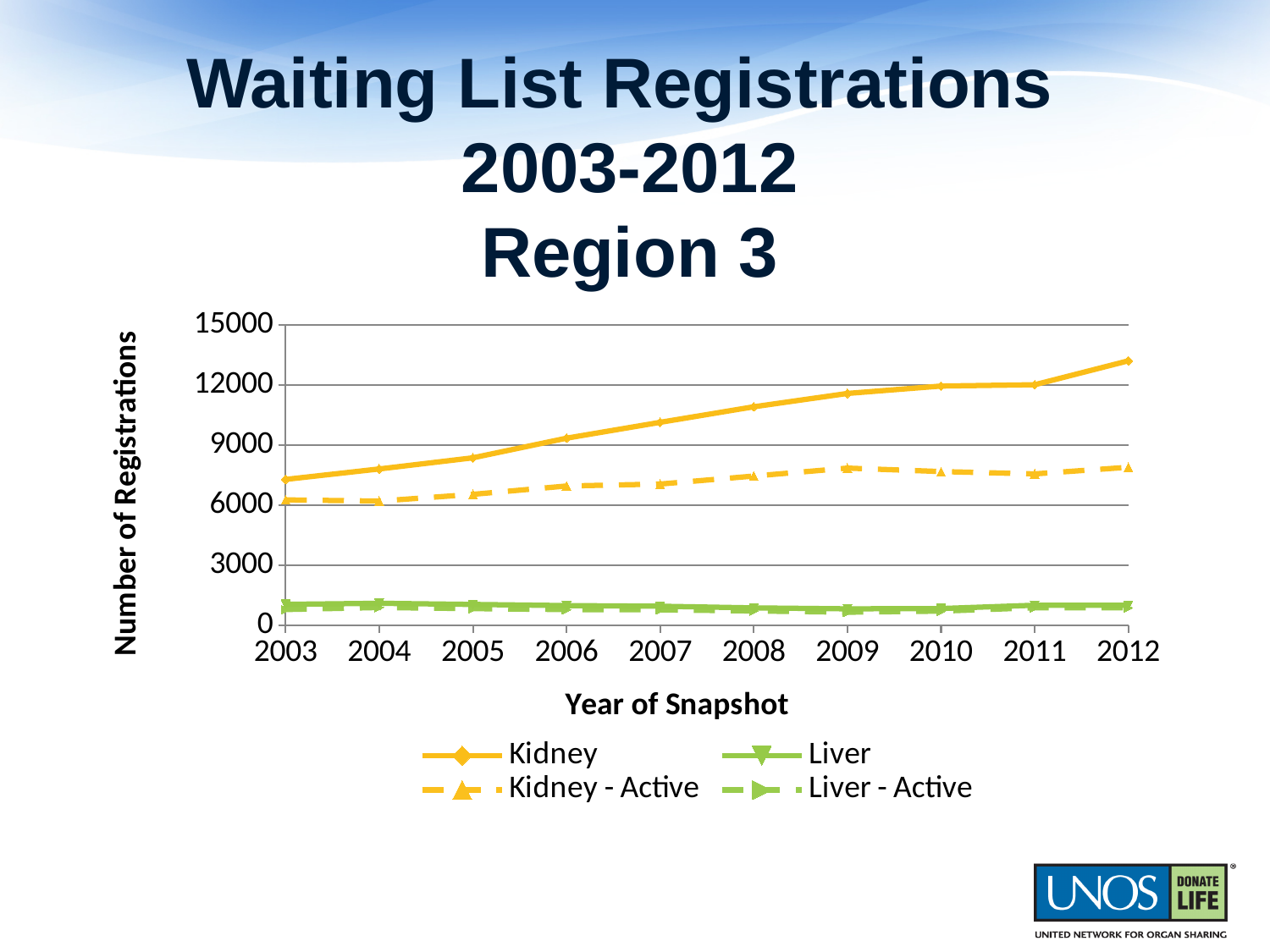
Is the value for Liver in 2012 greater or less than 3000? less Is the value for Kidney in 2012 greater or less than 12000? greater What kind of chart is shown on the slide? line chart In which year is the Kidney series at its lowest? 2003 Does the Kidney series rise or fall from 2003 to 2012? rise Is the value for Kidney - Active in 2009 greater or less than 9000? less In 2012, which is larger: Kidney or Kidney - Active? Kidney What is the label of the y axis? Number of Registrations In which year is the Kidney series at its highest? 2012 How many series does the legend list? 4 How many years are plotted along the x axis? 10